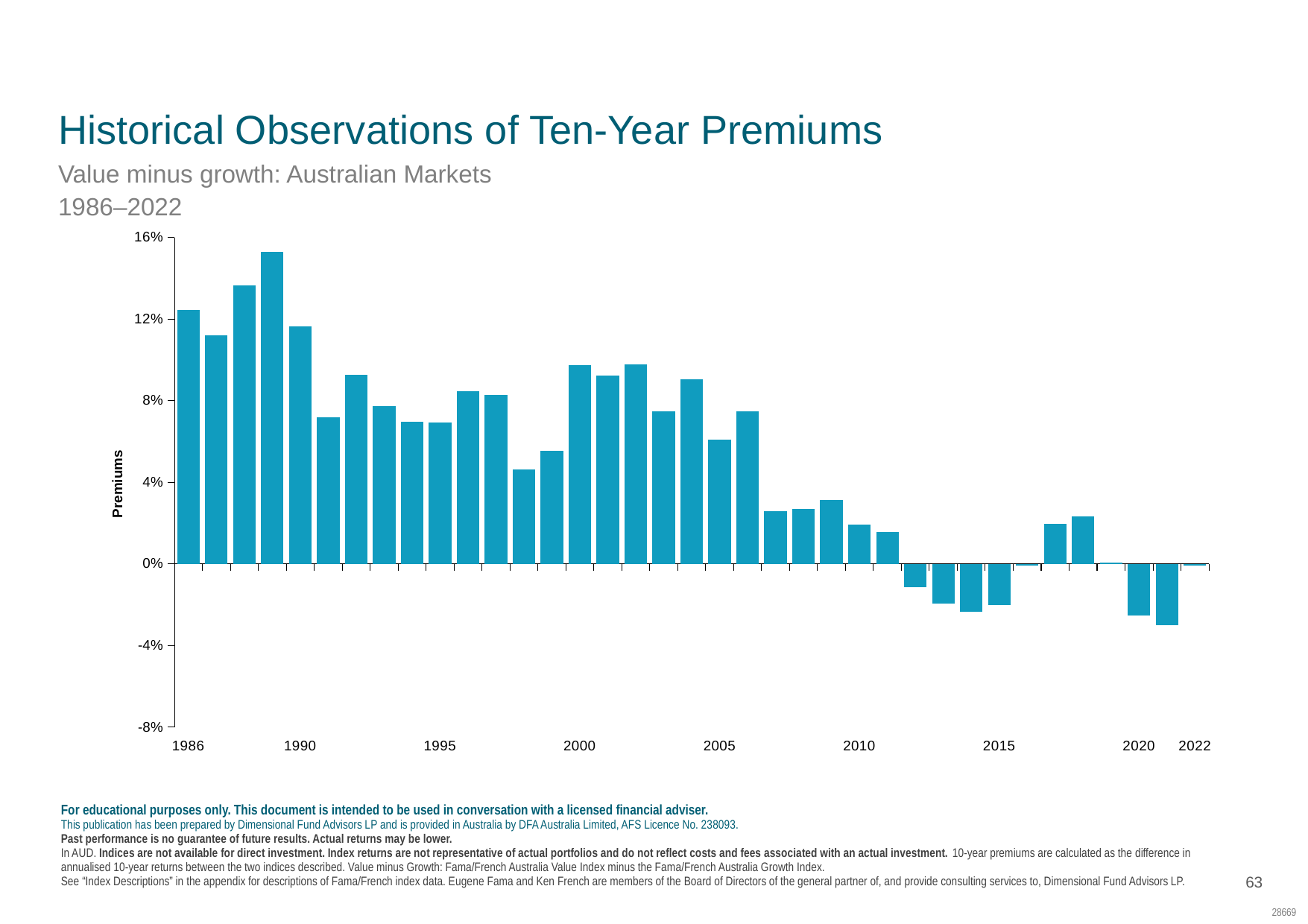
Do the ten-year premiums generally rise or fall from 1986 to 2022? Fall Is the value for 2015 greater or less than 0%? less Is the value for 1990 greater or less than 8%? greater Is the value for 2020 greater or less than 0%? less What is the label on the vertical axis of the chart? Premiums What kind of chart is shown on the slide? Bar chart Which is larger, the value for 1986 or the value for 2000? 1986 How many years (bars) are plotted in the chart? 37 Which year has the highest ten-year premium? 1989 Which year has the lowest ten-year premium? 2021